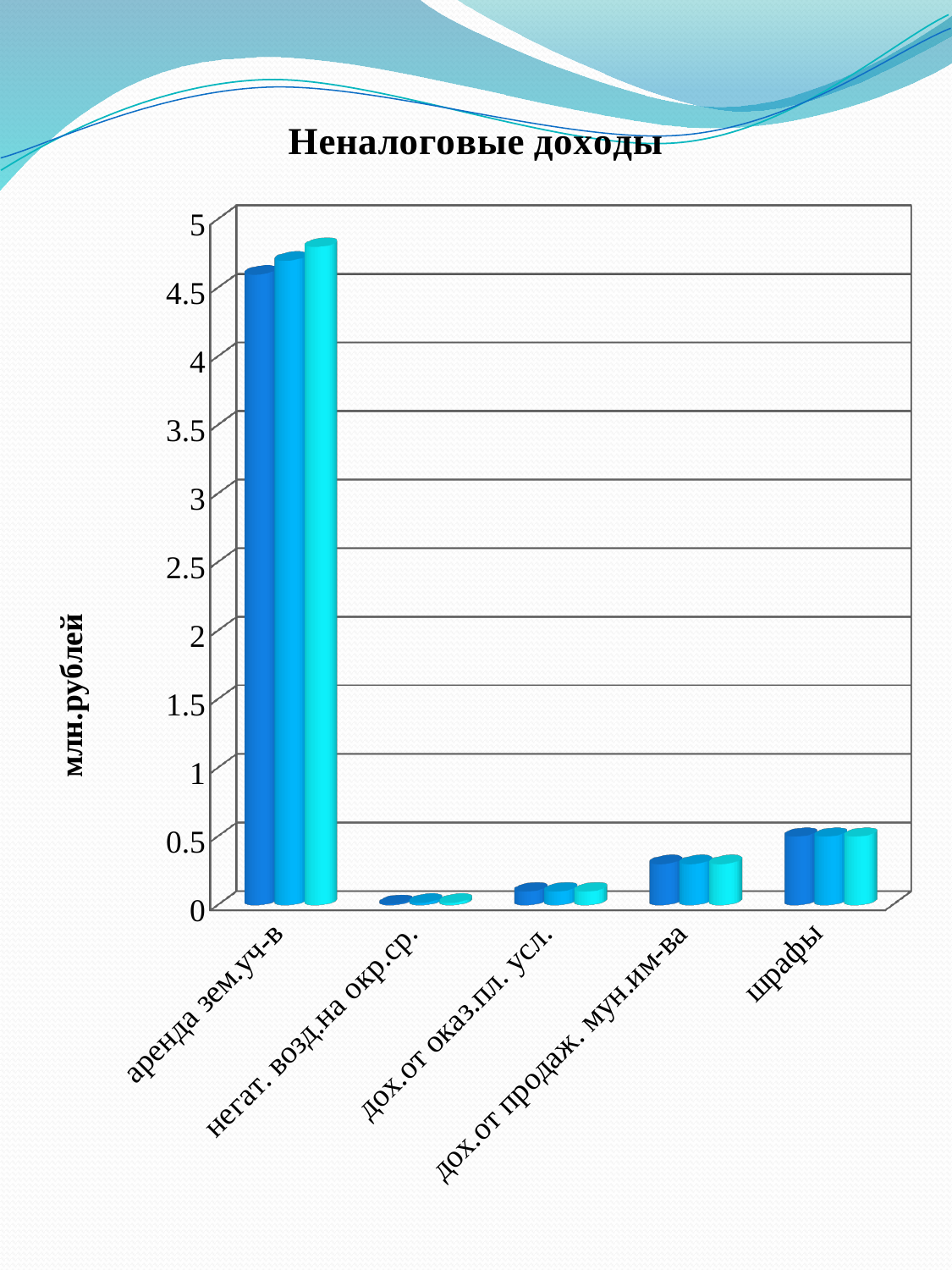
What is the label of the vertical axis? млн.рублей What is the title of the chart? Неналоговые доходы Are the values for дох.от оказ.пл. усл. greater or less than 0.5? less Which category has the lowest values in the chart? негат. возд.на окр.ср. Which category has larger values: шрафы or негат. возд.на окр.ср.? шрафы How many bars are plotted for each category in the chart? 3 Which category has larger values: аренда зем.уч-в or дох.от продаж. мун.им-ва? аренда зем.уч-в How many categories are shown on the x axis of the chart? 5 Are the values for аренда зем.уч-в greater or less than 4? greater Which category has the highest values in the chart? аренда зем.уч-в What type of chart is shown on the slide? bar chart Are the values for дох.от продаж. мун.им-ва greater or less than 1? less